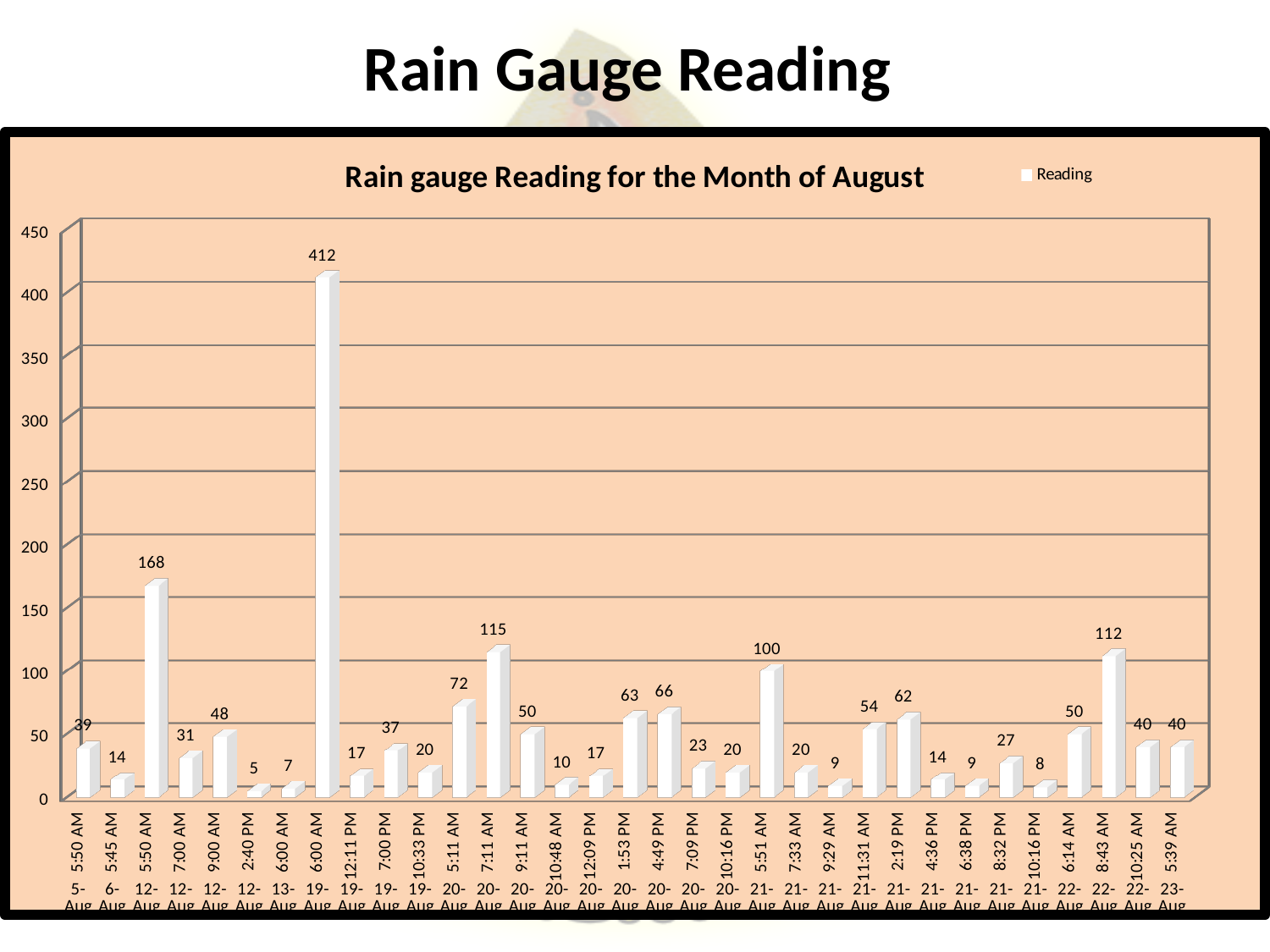
Which time and date has the highest reading? 6:00 AM 19-Aug What is the reading at 8:43 AM on 22-Aug? 112 What is the title of the chart? Rain gauge Reading for the Month of August What is the reading at 5:50 AM on 12-Aug? 168 What is the difference between the reading at 6:00 AM on 19-Aug and the reading at 5:50 AM on 12-Aug? 244 Which time and date has the lowest reading? 2:40 PM 12-Aug Which is larger, the reading at 5:51 AM on 21-Aug or the reading at 7:11 AM on 20-Aug? 7:11 AM 20-Aug Is the reading at 5:11 AM on 20-Aug greater or less than 50? greater What is the reading at 7:11 AM on 20-Aug? 115 What type of chart is shown on the slide? Bar chart What is the reading at 6:00 AM on 19-Aug? 412 How many bars are plotted in the chart? 33